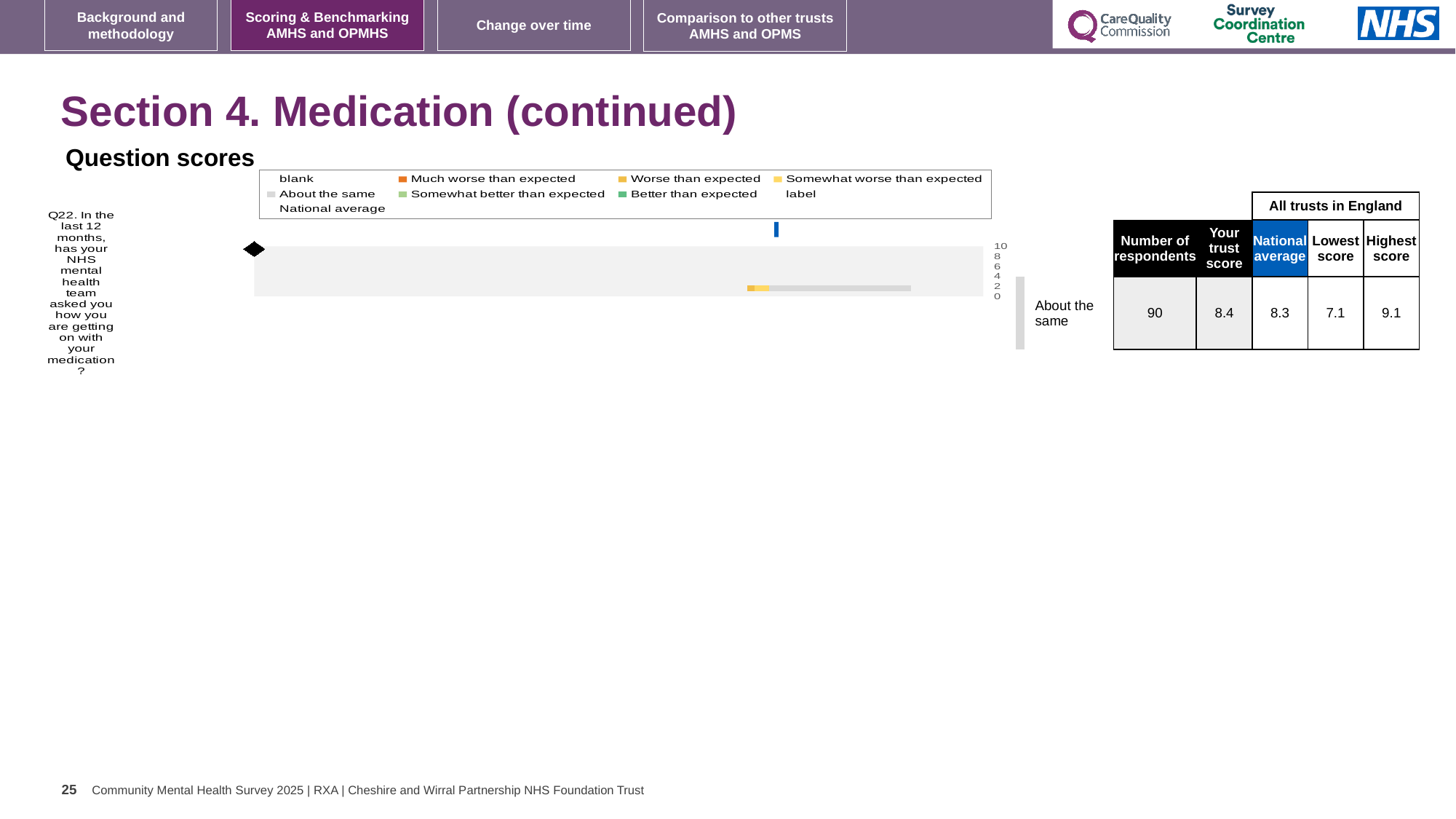
How many questions (categories) are plotted in the Question scores chart? 1 In the table beside the chart, what is the number of respondents for Q22? 90 How many entries does the legend of the Question scores chart list? 9 In the table beside the chart, what is the highest score among all trusts in England for Q22? 9.1 In the table beside the chart, what is the lowest score among all trusts in England for Q22? 7.1 Which question is plotted in the Question scores chart? Q22. In the last 12 months, has your NHS mental health team asked you how you are getting on with your medication? In the table beside the chart, what is the national average for Q22? 8.3 In the table beside the chart, which is larger for Q22: your trust score or the national average? Your trust score What benchmark category is shown for Q22 next to the chart? About the same In the table beside the chart, what is your trust score for Q22? 8.4 What is the highest tick value shown on the axis of the Question scores chart? 10 What kind of chart is shown under 'Question scores'? bar chart